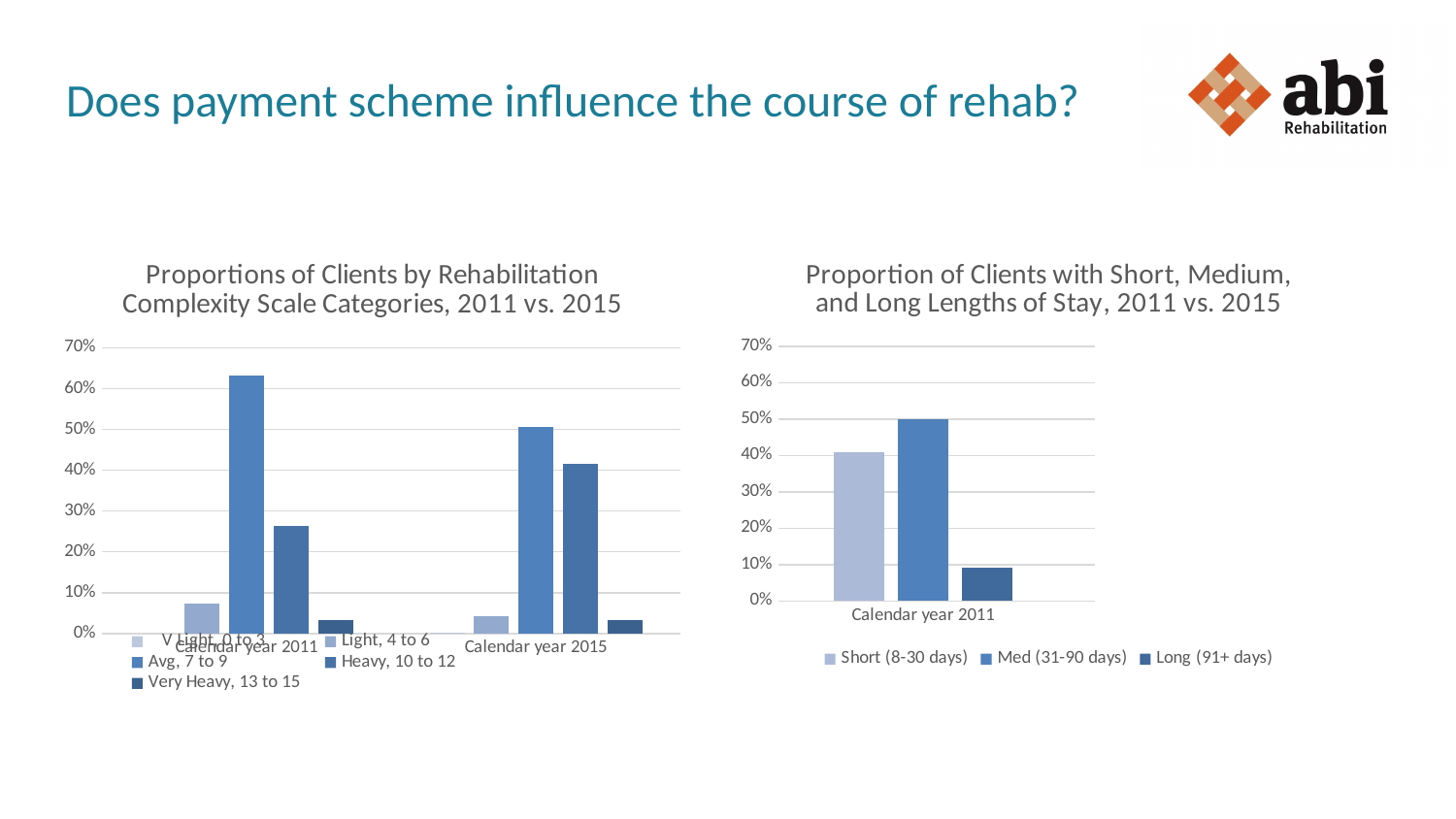
In the left chart (Rehabilitation Complexity Scale Categories), does the value for Avg, 7 to 9 rise or fall from Calendar year 2011 to Calendar year 2015? fall In the left chart (Rehabilitation Complexity Scale Categories), how many series does the legend list? 5 In the left chart (Rehabilitation Complexity Scale Categories), is the value for Avg, 7 to 9 in Calendar year 2011 greater or less than 60%? greater In the left chart (Rehabilitation Complexity Scale Categories), is the value for Heavy, 10 to 12 larger in Calendar year 2011 or Calendar year 2015? Calendar year 2015 In the right chart (Lengths of Stay), is the value for Short (8-30 days) in Calendar year 2011 greater or less than 30%? greater In the right chart (Lengths of Stay), how many series does the legend list? 3 In the left chart (Rehabilitation Complexity Scale Categories), is the value for Heavy, 10 to 12 in Calendar year 2015 greater or less than 30%? greater In the left chart (Rehabilitation Complexity Scale Categories), which series has the highest value for Calendar year 2011? Avg, 7 to 9 What kind of chart is the left chart, 'Proportions of Clients by Rehabilitation Complexity Scale Categories, 2011 vs. 2015'? Bar chart In the left chart (Rehabilitation Complexity Scale Categories), how many calendar-year categories are shown on the x axis? 2 In the right chart (Lengths of Stay), which series has the lowest value for Calendar year 2011? Long (91+ days) In the right chart (Lengths of Stay), which series has the highest value for Calendar year 2011? Med (31-90 days)